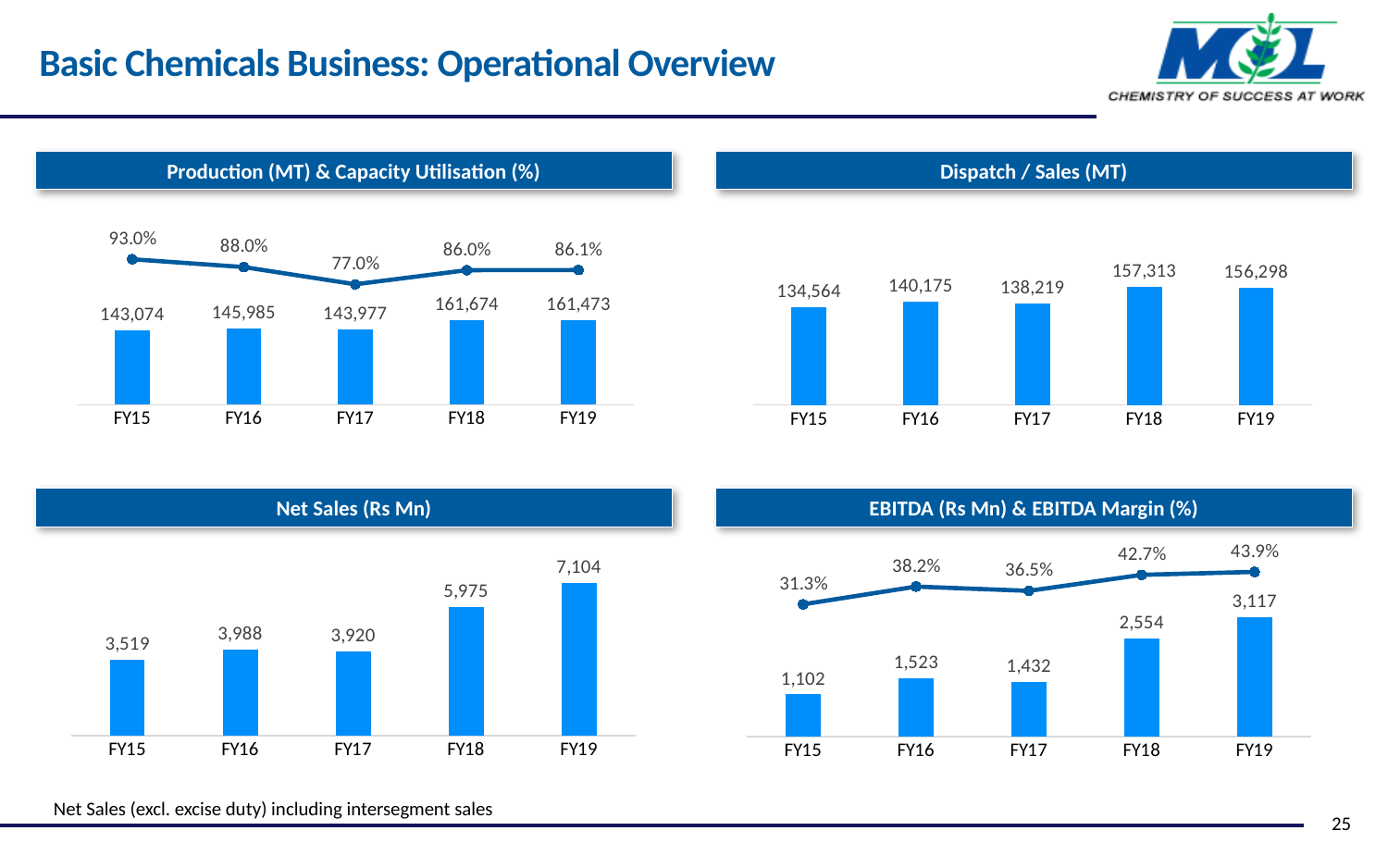
In the 'Net Sales (Rs Mn)' chart, how many years are shown? 5 In the 'Production (MT) & Capacity Utilisation (%)' chart, what is the capacity utilisation for FY17? 77.0% In the 'EBITDA (Rs Mn) & EBITDA Margin (%)' chart, what is the EBITDA margin for FY15? 31.3% What kind of chart is the 'Net Sales (Rs Mn)' chart? Bar chart In the 'Net Sales (Rs Mn)' chart, which is larger, FY16 or FY17? FY16 In the 'Dispatch / Sales (MT)' chart, which year has the lowest value? FY15 In the 'Dispatch / Sales (MT)' chart, what is the value for FY16? 140,175 In the 'Net Sales (Rs Mn)' chart, what is the value for FY19? 7,104 In the 'Production (MT) & Capacity Utilisation (%)' chart, what is the production value for FY18? 161,674 In the 'EBITDA (Rs Mn) & EBITDA Margin (%)' chart, what is the EBITDA for FY18? 2,554 In the 'Dispatch / Sales (MT)' chart, what is the difference between FY18 and FY17? 19,094 In the 'Production (MT) & Capacity Utilisation (%)' chart, which year has the highest capacity utilisation? FY15